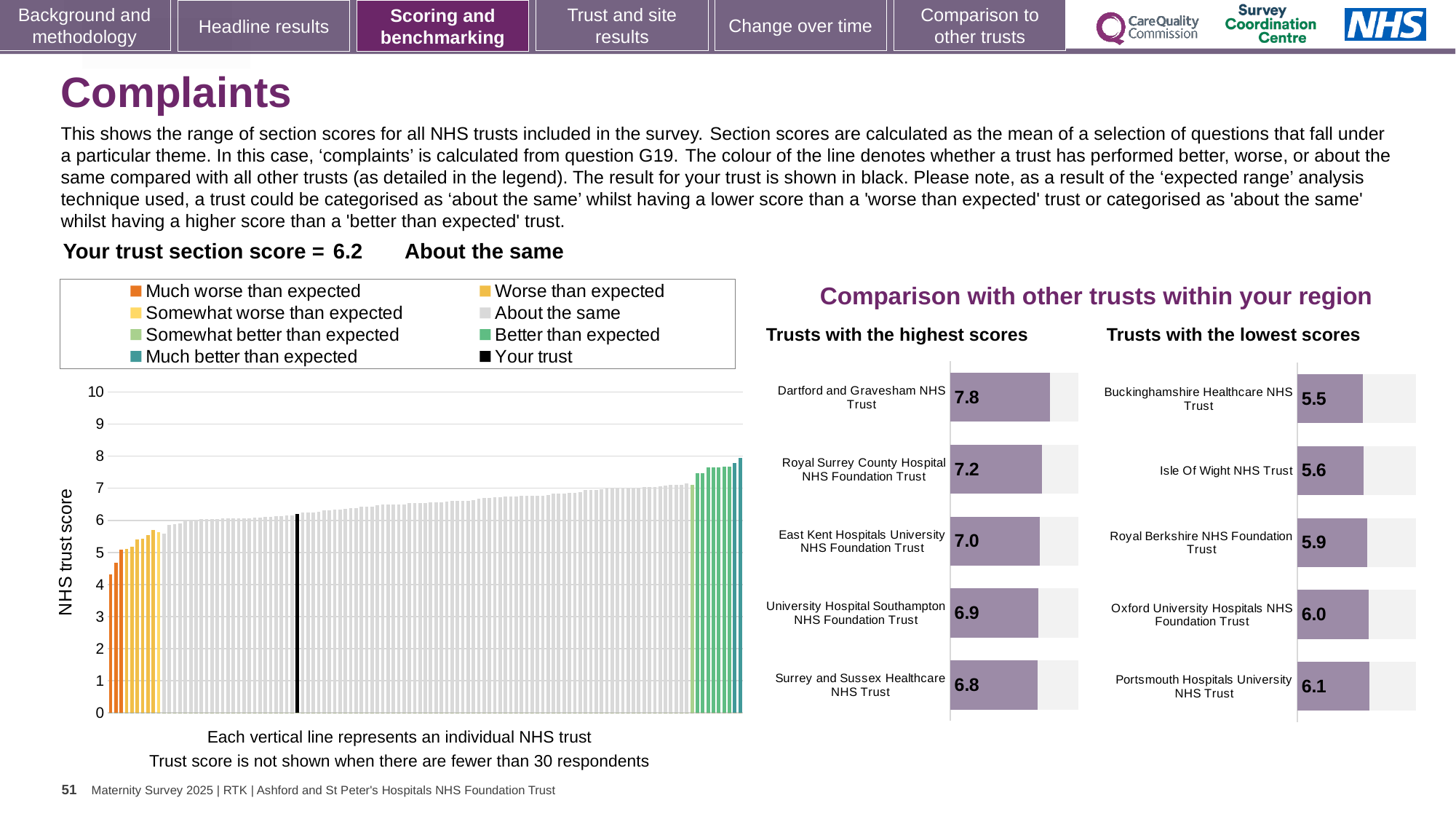
How many entries does the legend of the large chart on the left list? 8 In the 'Trusts with the highest scores' chart, what is the score for University Hospital Southampton NHS Foundation Trust? 6.9 In the 'Trusts with the highest scores' chart, what is the difference between the scores of Dartford and Gravesham NHS Trust and Surrey and Sussex Healthcare NHS Trust? 1.0 In the large chart on the left, is the value for the lowest-scoring trust (the leftmost bar) greater or less than 5? less How many trusts are shown in the 'Trusts with the highest scores' chart? 5 In the 'Trusts with the highest scores' chart, which trust has the highest score? Dartford and Gravesham NHS Trust In the 'Trusts with the highest scores' chart, what is the score for Dartford and Gravesham NHS Trust? 7.8 In the 'Trusts with the lowest scores' chart, which trust has the lowest score? Buckinghamshire Healthcare NHS Trust What kind of chart is the large chart on the left showing NHS trust scores? Bar chart In the 'Trusts with the lowest scores' chart, what is the score for Royal Berkshire NHS Foundation Trust? 5.9 In the 'Trusts with the lowest scores' chart, what is the difference between the scores of Portsmouth Hospitals University NHS Trust and Buckinghamshire Healthcare NHS Trust? 0.6 In the 'Trusts with the lowest scores' chart, which has the larger score: Isle Of Wight NHS Trust or Oxford University Hospitals NHS Foundation Trust? Oxford University Hospitals NHS Foundation Trust